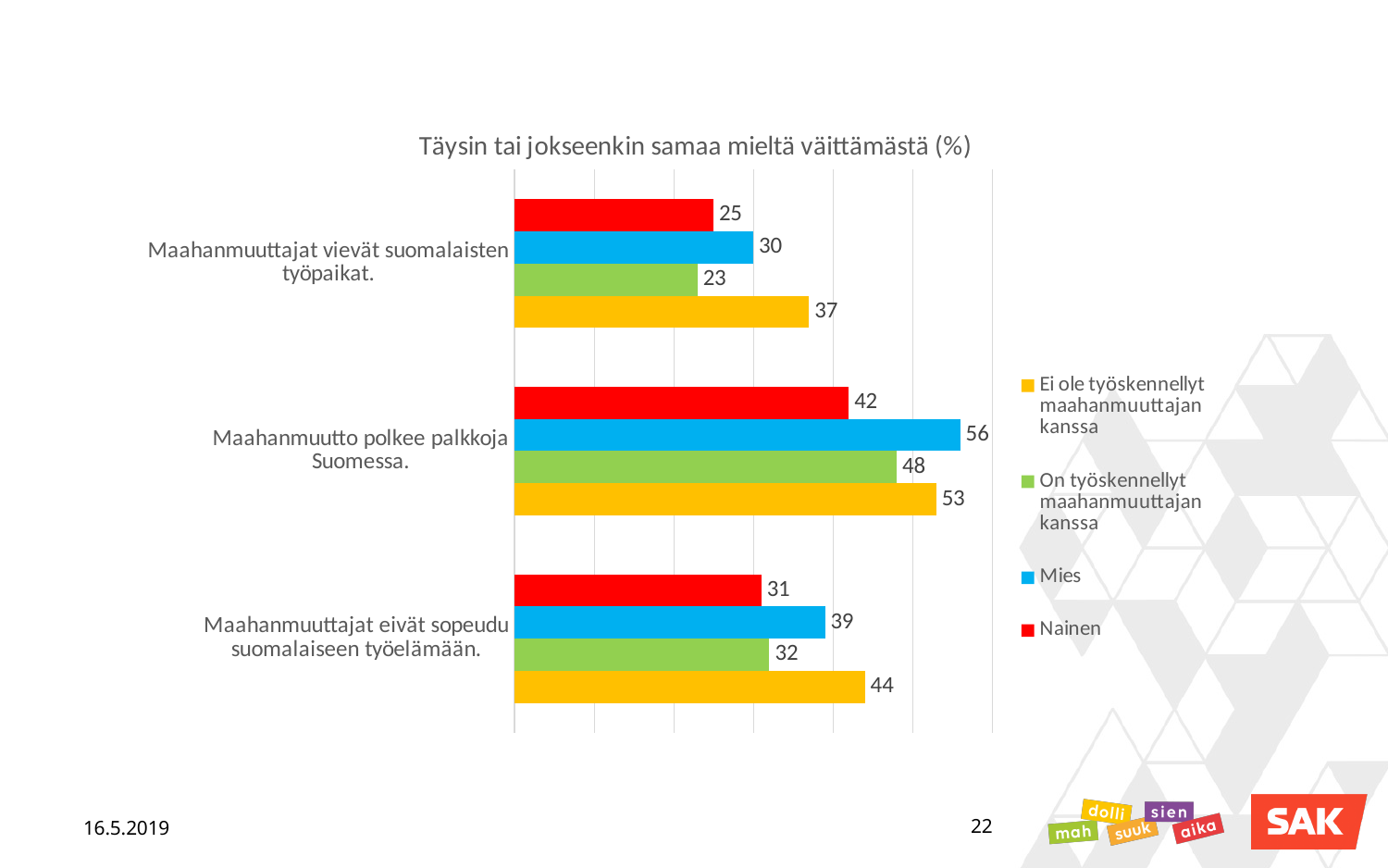
What type of chart is shown on the slide? Bar chart How many series does the legend list? 4 What is the value for Mies for the statement "Maahanmuutto polkee palkkoja Suomessa."? 56 Which series has the highest value for the statement "Maahanmuutto polkee palkkoja Suomessa."? Mies What is the value for "Ei ole työskennellyt maahanmuuttajan kanssa" for the statement "Maahanmuuttajat eivät sopeudu suomalaiseen työelämään."? 44 What is the value for Nainen for the statement "Maahanmuuttajat vievät suomalaisten työpaikat."? 25 Which series has the lowest value for the statement "Maahanmuuttajat eivät sopeudu suomalaiseen työelämään."? Nainen What is the difference between the Mies and Nainen values for the statement "Maahanmuutto polkee palkkoja Suomessa."? 14 For the statement "Maahanmuuttajat eivät sopeudu suomalaiseen työelämään.", which is larger: the value for Mies or the value for "On työskennellyt maahanmuuttajan kanssa"? Mies What is the difference between the "Ei ole työskennellyt maahanmuuttajan kanssa" and "On työskennellyt maahanmuuttajan kanssa" values for the statement "Maahanmuuttajat vievät suomalaisten työpaikat."? 14 What is the value for "On työskennellyt maahanmuuttajan kanssa" for the statement "Maahanmuuttajat vievät suomalaisten työpaikat."? 23 How many statements (categories) are shown in the chart? 3